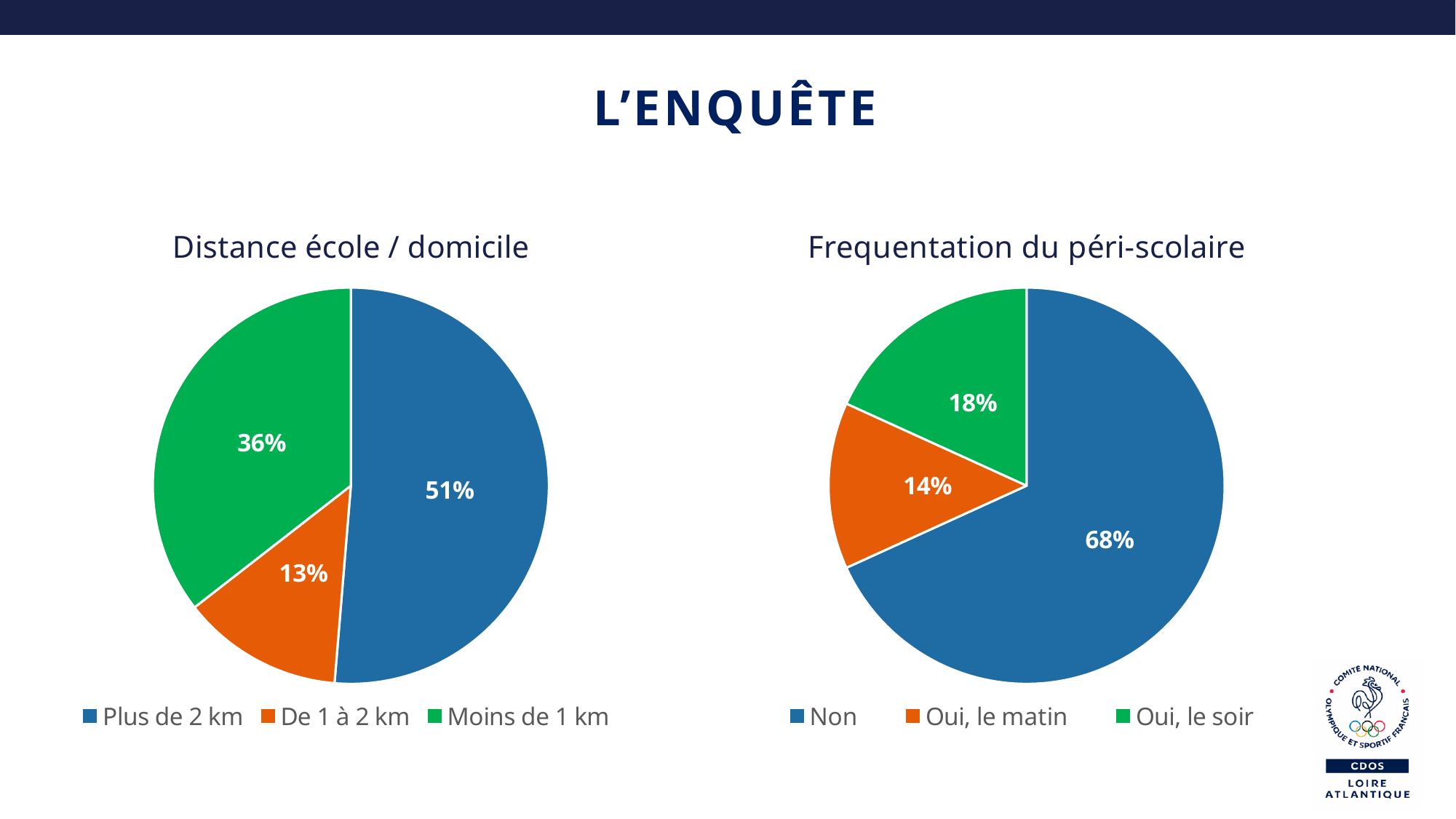
In the 'Distance école / domicile' chart, what colour is the 'De 1 à 2 km' slice? Orange In the 'Frequentation du péri-scolaire' chart, what share is labelled for 'Oui, le soir'? 18% How many categories does the 'Frequentation du péri-scolaire' chart show? 3 In the 'Frequentation du péri-scolaire' chart, which category has the smallest slice? Oui, le matin In the 'Distance école / domicile' chart, what share is labelled for 'Moins de 1 km'? 36% In the 'Frequentation du péri-scolaire' chart, which is larger: 'Oui, le matin' or 'Oui, le soir'? Oui, le soir In the 'Distance école / domicile' chart, what share is labelled for 'De 1 à 2 km'? 13% In the 'Distance école / domicile' chart, what is the difference in percentage points between 'Plus de 2 km' and 'Moins de 1 km'? 15 In the 'Distance école / domicile' chart, which category has the largest slice? Plus de 2 km What kind of chart is 'Distance école / domicile'? Pie chart In the 'Distance école / domicile' chart, what share is labelled for 'Plus de 2 km'? 51% In the 'Frequentation du péri-scolaire' chart, what share is labelled for 'Non'? 68%